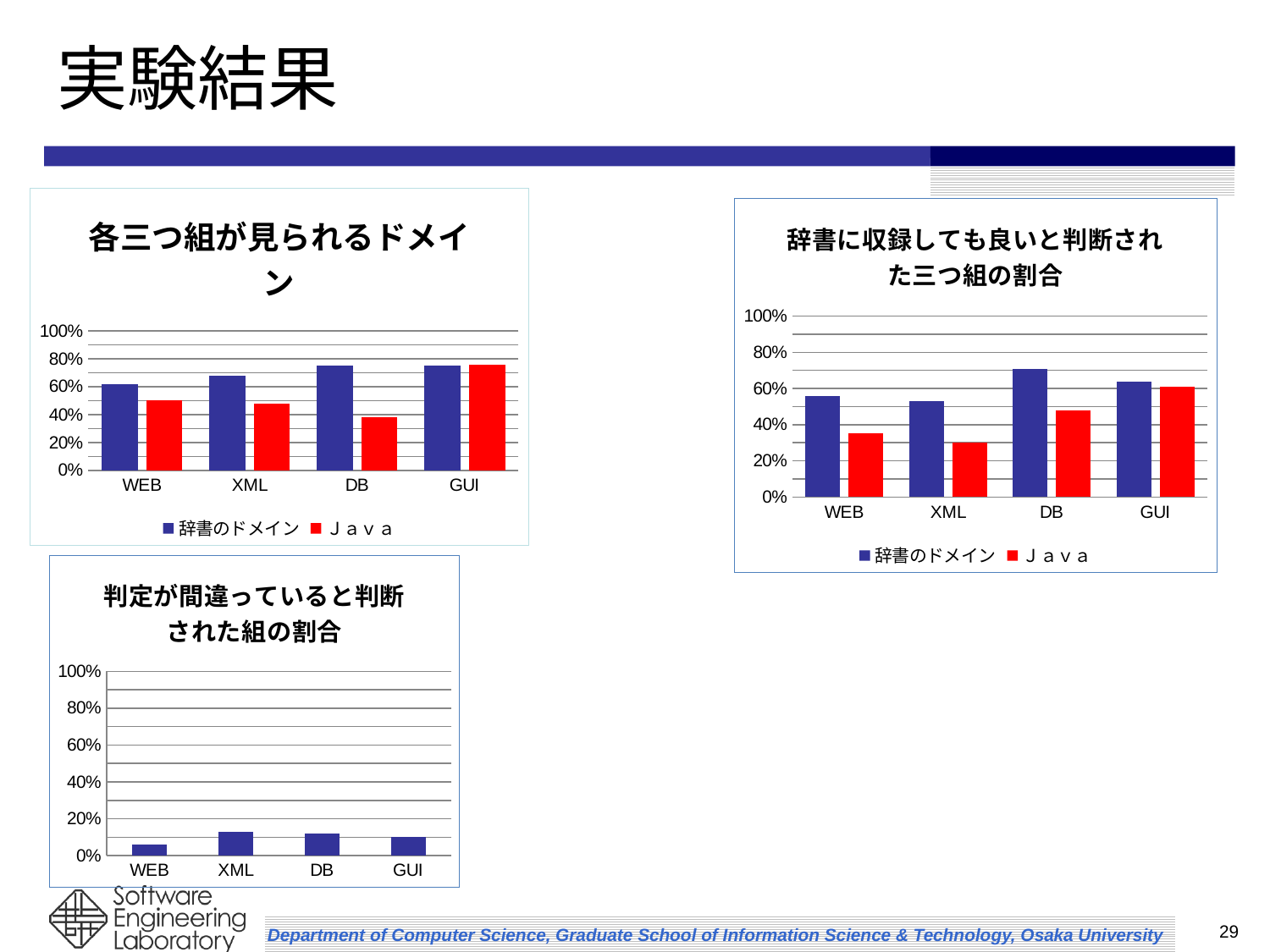
In the chart titled 「辞書に収録しても良いと判断された三つ組の割合」, which category has the highest value for the Java series? GUI In the chart titled 「各三つ組が見られるドメイン」, is the 辞書のドメイン value for DB greater or less than 60%? greater In the chart titled 「辞書に収録しても良いと判断された三つ組の割合」, which is larger for WEB: the 辞書のドメイン value or the Java value? 辞書のドメイン In the chart titled 「各三つ組が見られるドメイン」, how many series does the legend list? 2 In the chart titled 「各三つ組が見られるドメイン」, which category has the lowest value for the Java series? DB What type of chart is the chart titled 「判定が間違っていると判断された組の割合」? bar chart In the chart titled 「判定が間違っていると判断された組の割合」, which category has the lowest value? WEB In the chart titled 「辞書に収録しても良いと判断された三つ組の割合」, which category has the highest value for the 辞書のドメイン series? DB In the chart titled 「辞書に収録しても良いと判断された三つ組の割合」, is the Java value for XML greater or less than 40%? less In the chart titled 「判定が間違っていると判断された組の割合」, is the value for XML greater or less than 20%? less In the chart titled 「各三つ組が見られるドメイン」, how many categories are shown on the x axis? 4